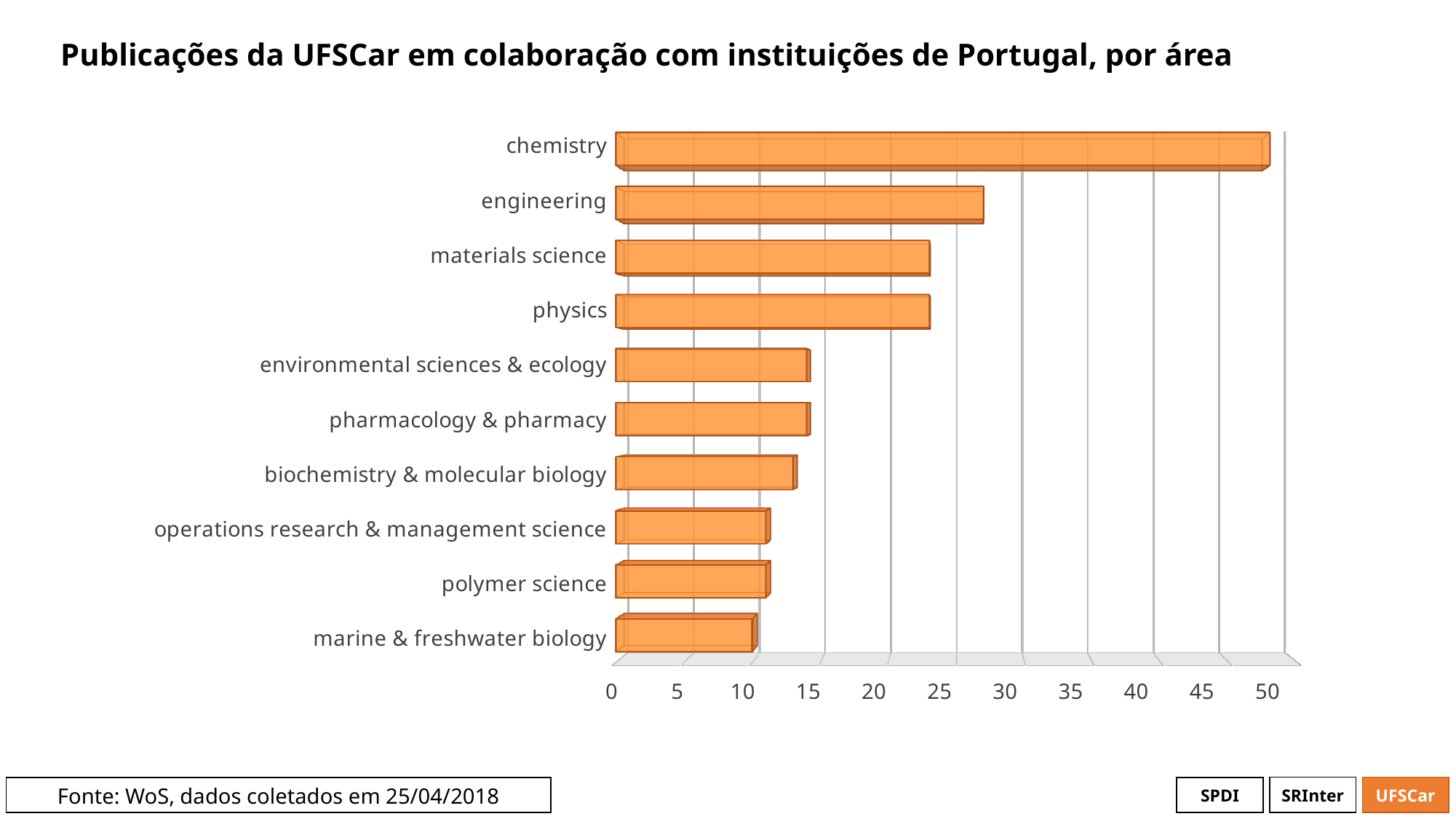
Is the value for environmental sciences & ecology greater or less than 20? less Is the value for chemistry greater or less than 45? greater Is the value for materials science greater or less than 25? less What is the title of the chart? Publicações da UFSCar em colaboração com instituições de Portugal, por área Which has more publications, chemistry or engineering? chemistry Which area has the lowest number of publications? marine & freshwater biology What kind of chart is shown on the slide? bar chart Which has more publications, engineering or materials science? engineering Which area has the highest number of publications? chemistry How many areas (categories) are shown in the chart? 10